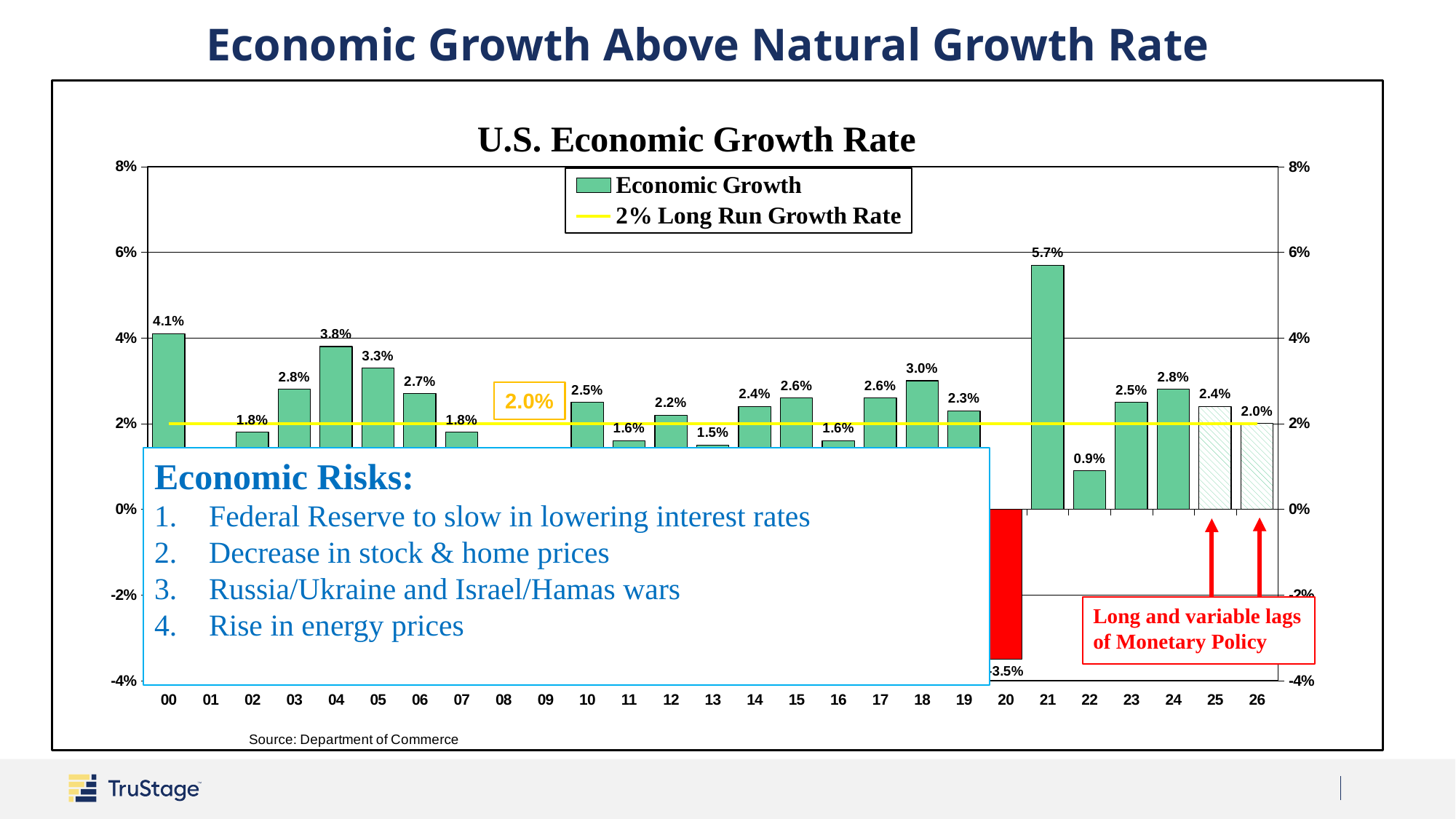
What is the title of the chart? U.S. Economic Growth Rate Which year has the lowest economic growth rate? 20 What type of chart is used to show Economic Growth? bar chart Is the economic growth rate for 13 greater or less than 2%? less How many series does the legend list? 2 What is the economic growth rate for 22? 0.9% Which year has the highest economic growth rate? 21 What value does the yellow line represent according to the legend? 2% Long Run Growth Rate What is the economic growth rate for 21? 5.7% Which year has a higher economic growth rate, 00 or 05? 00 What is the economic growth rate for 04? 3.8% What is the difference between the economic growth rate for 21 and for 22? 4.8%